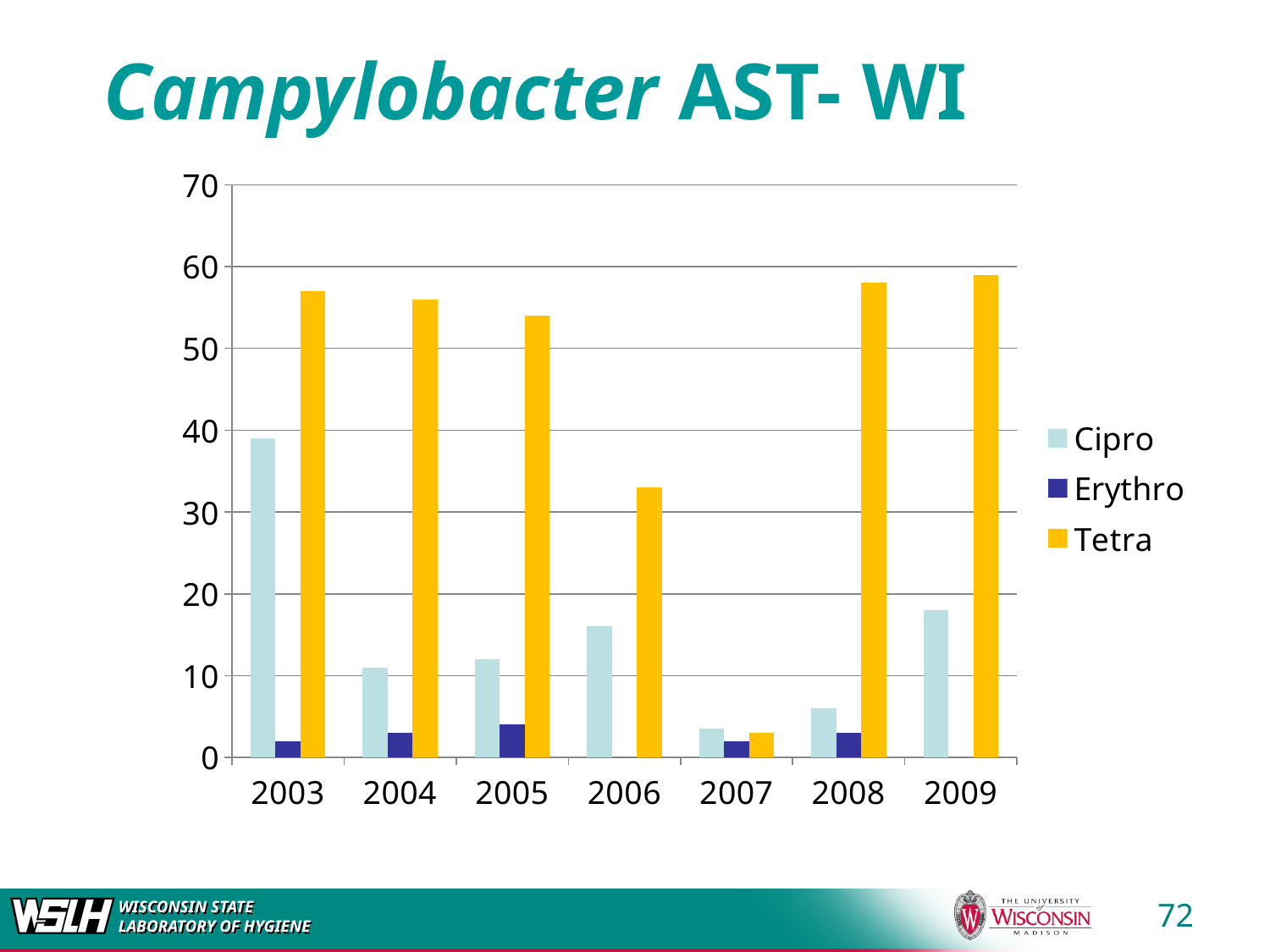
How many years are shown on the x axis? 7 What kind of chart is shown on the slide? bar chart Which year has the lowest Cipro value? 2007 Which year has the highest Cipro value? 2003 Is the Cipro value for 2003 greater or less than 30? greater In 2003, which is larger, the Cipro value or the Tetra value? Tetra Which series is shown in yellow in the legend? Tetra Is the Cipro value for 2009 greater or less than 20? less Is the Tetra value for 2006 greater or less than 40? less Which year has the lowest Tetra value? 2007 How many series does the legend list? 3